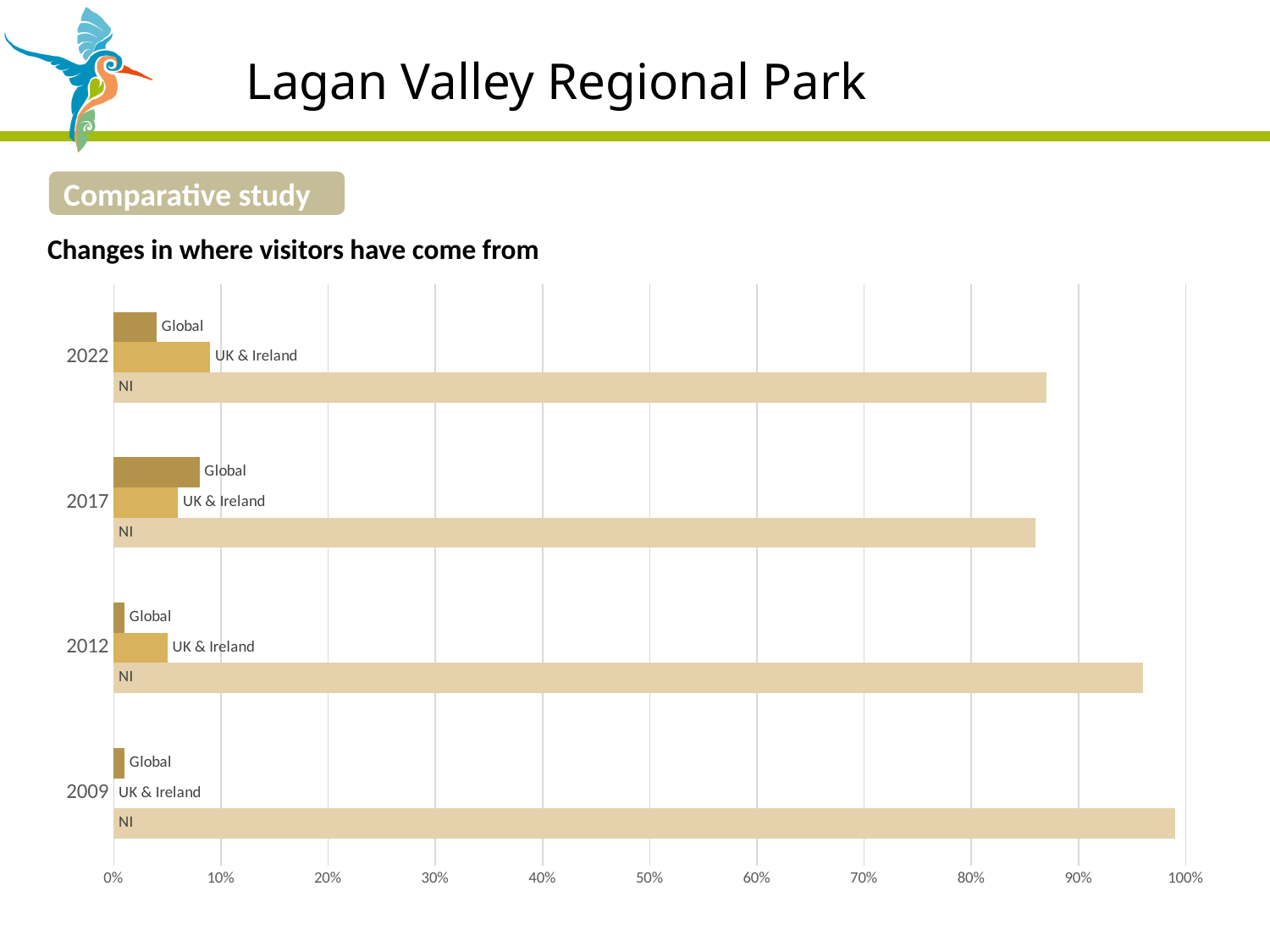
How many years are shown on the chart? 4 How many visitor-origin series are shown for each year? 3 Is the NI value for 2009 greater or less than 90%? greater Which year has the highest NI value? 2009 Does the NI value rise or fall from 2009 to 2017? fall In 2022, which is larger: UK & Ireland or Global? UK & Ireland What is the title of the chart? Changes in where visitors have come from Is the NI value for 2022 greater or less than 90%? less What kind of chart is shown on the slide? bar chart Is the UK & Ireland value for 2022 greater or less than 10%? less Which year has the highest Global value? 2017